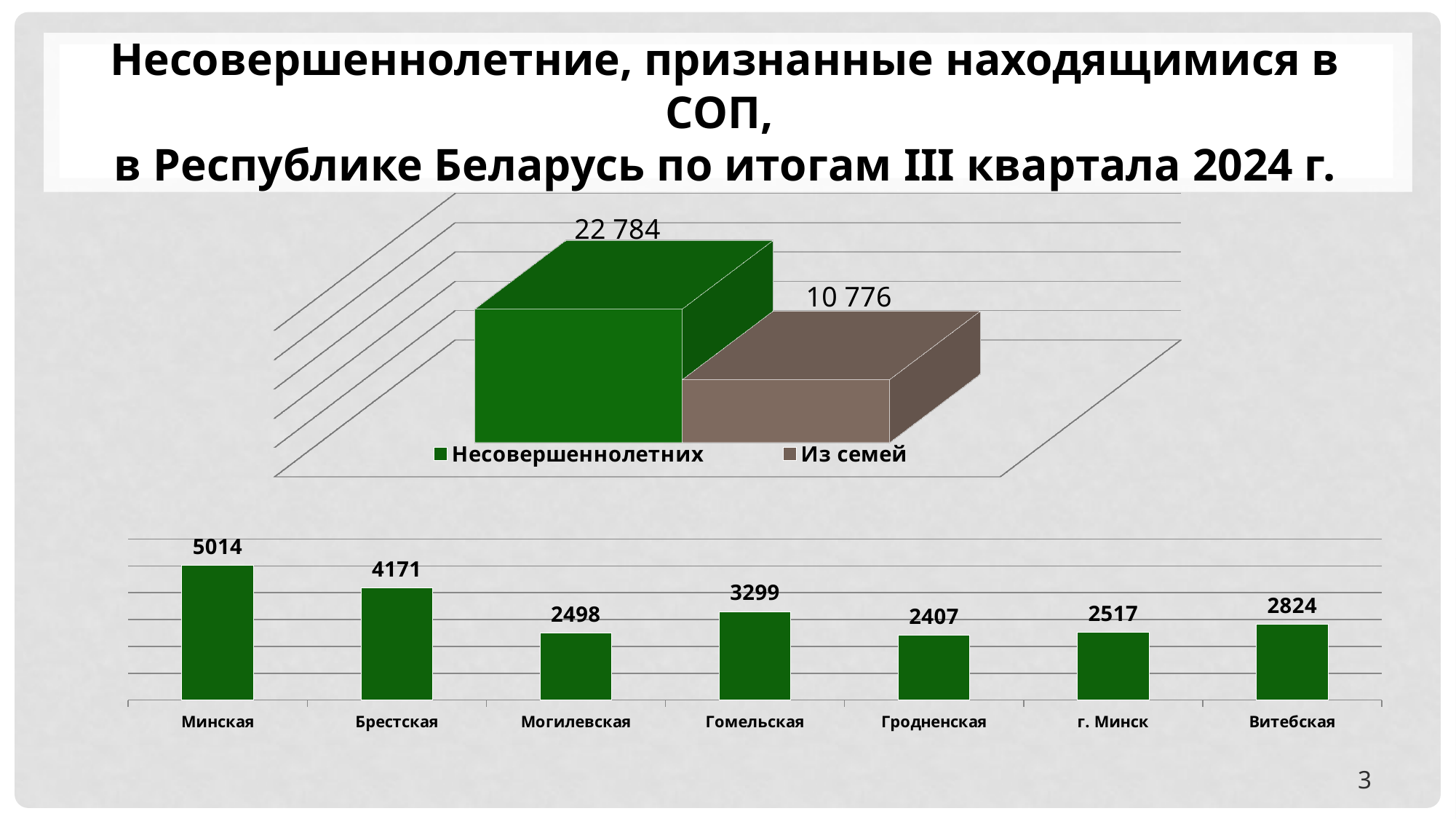
In the top chart, what is the value for Несовершеннолетних? 22 784 In the top chart, what is the difference between Несовершеннолетних and Из семей? 12 008 In the bottom chart, what is the difference between Минская and Брестская? 843 In the bottom chart, which is larger, Витебская or г. Минск? Витебская In the bottom chart, how many regions are shown? 7 In the bottom chart, what is the value for Гомельская? 3299 In the bottom chart, which region has the highest value? Минская In the top chart, how many series does the legend list? 2 In the bottom chart, which region has the lowest value? Гродненская In the bottom chart, what is the value for Минская? 5014 What kind of chart is the bottom chart? Bar chart In the top chart, what is the value for Из семей? 10 776